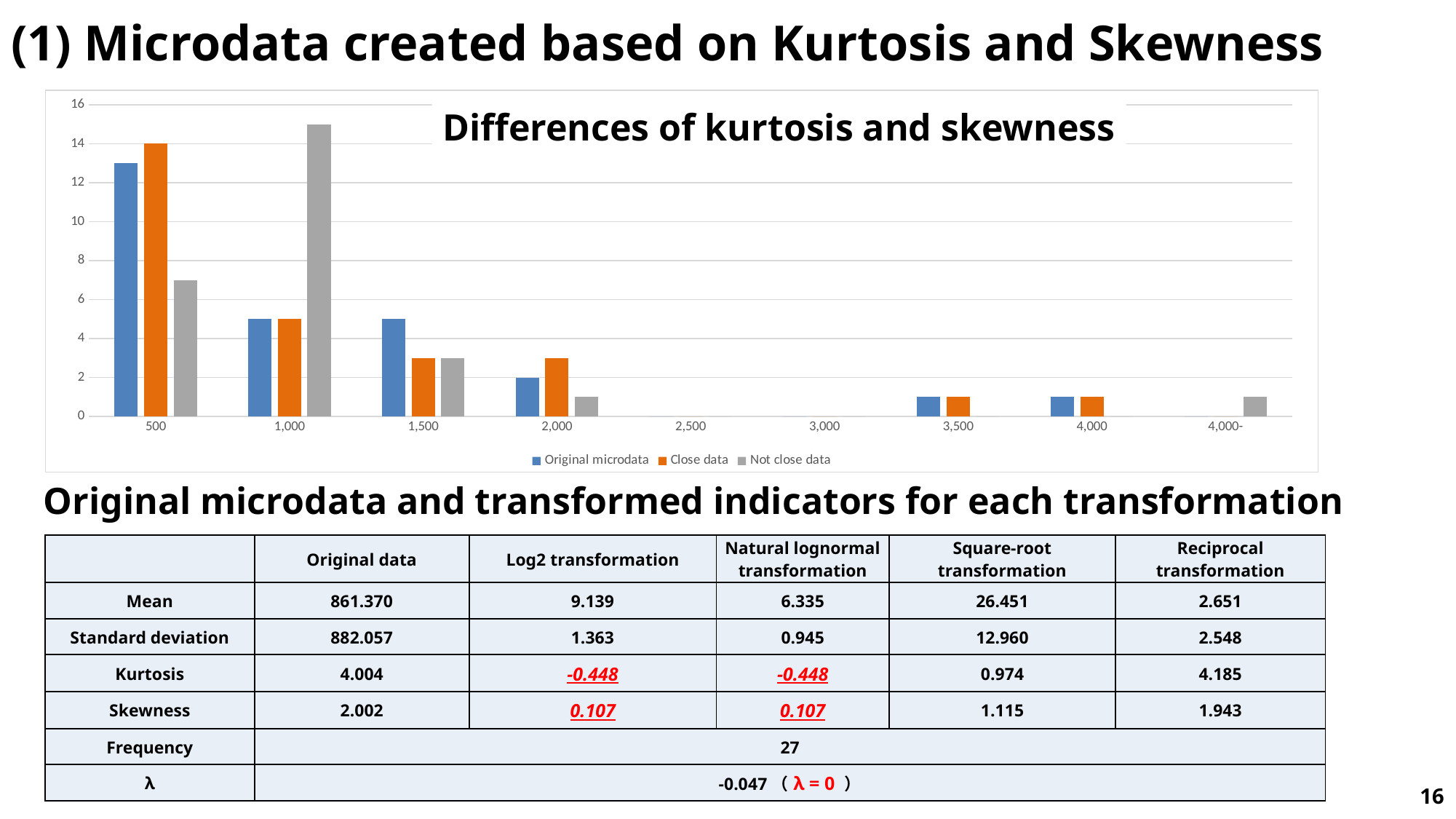
How many series does the chart legend list? 3 Is the value for Original microdata in the 500 category greater or less than 12? greater What is the value for Original microdata in the 2,000 category? 2 In the 500 category, which is larger: Close data or Not close data? Close data Which category has the highest Not close data bar? 1,000 Which series is shown in orange in the chart? Close data What kind of chart is shown on the slide? bar chart How many categories are shown on the x axis of the chart? 9 What is the value for Close data in the 500 category? 14 What is the title of the chart? Differences of kurtosis and skewness Which category has the highest Original microdata bar? 500 Is the value for Not close data in the 1,000 category greater or less than 14? greater